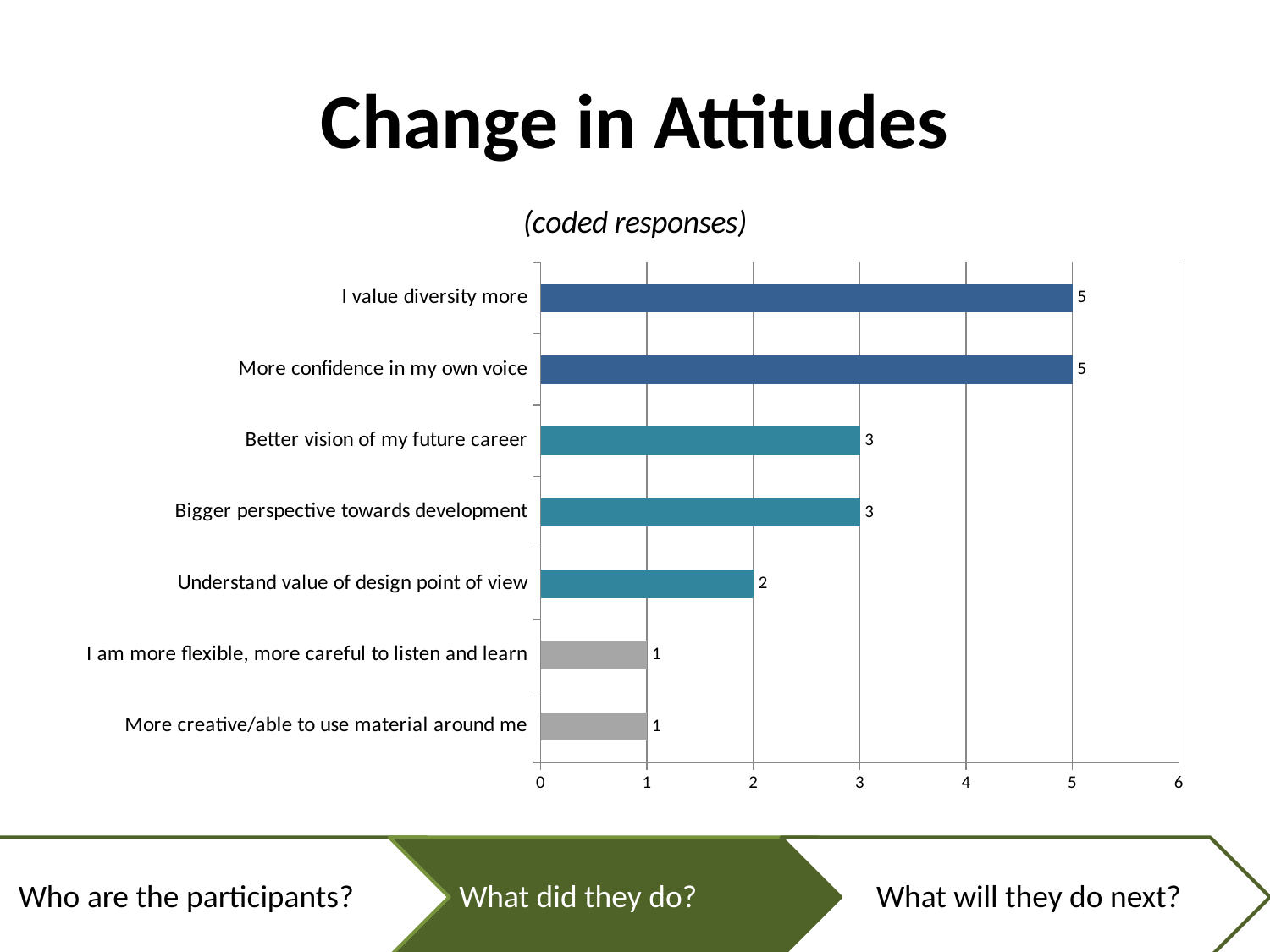
How many categories are shown in the chart? 7 What is the value for "Better vision of my future career"? 3 What is the difference between "More confidence in my own voice" and "Bigger perspective towards development"? 2 What kind of chart is shown on the slide? bar chart What is the value for "Understand value of design point of view"? 2 What is the value for "More creative/able to use material around me"? 1 What is the subtitle shown above the chart? (coded responses) What is the maximum value shown on the x axis? 6 Is the value for "I value diversity more" greater or less than 4? greater What is the value for "I value diversity more"? 5 Which is larger: "Understand value of design point of view" or "I am more flexible, more careful to listen and learn"? Understand value of design point of view Which categories have the highest value? I value diversity more; More confidence in my own voice